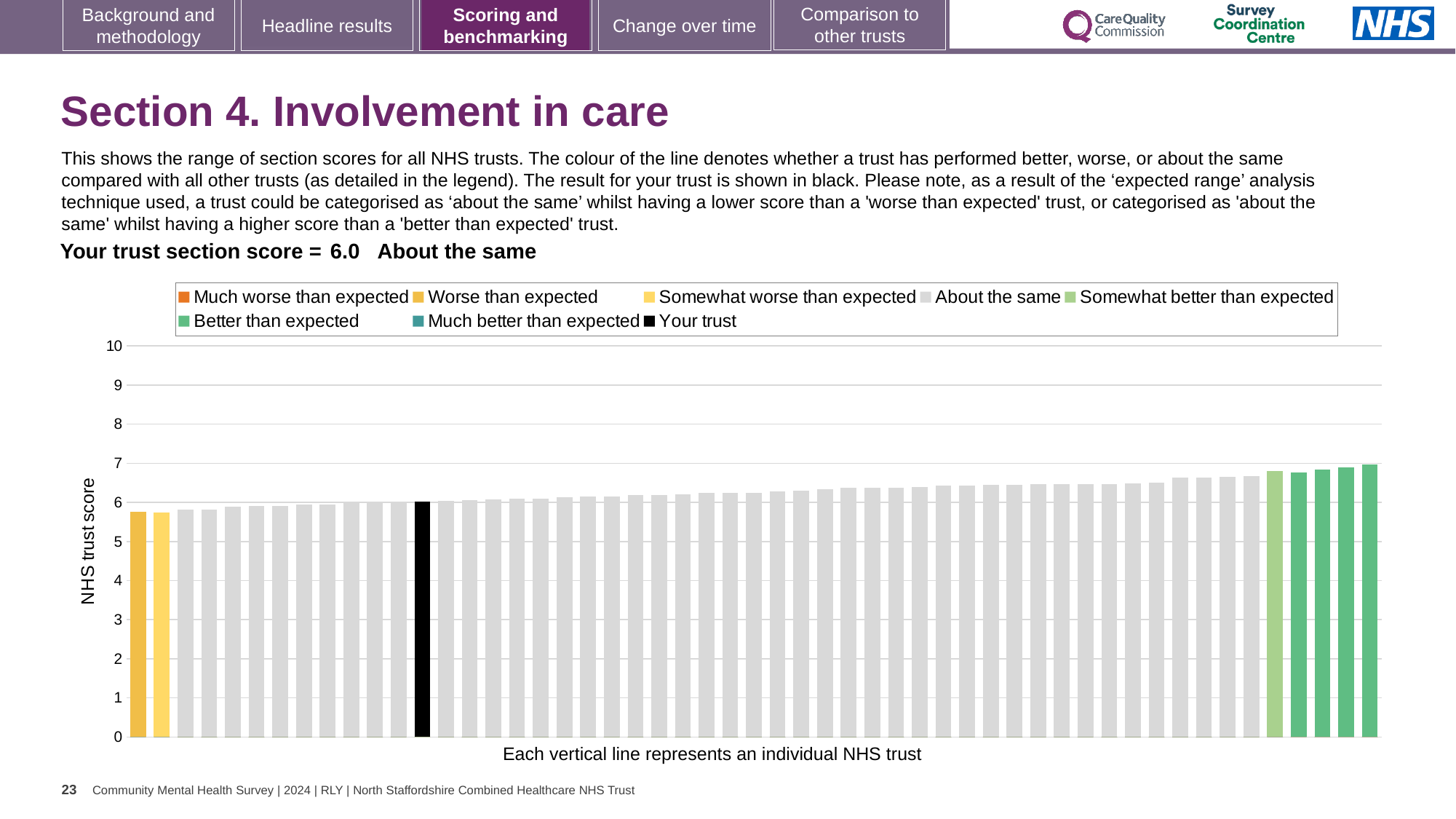
What is the label on the vertical axis of the chart? NHS trust score What is the section score for your trust shown on the slide? 6.0 How many entries does the chart legend list? 8 Is the value of the black 'Your trust' bar greater or less than 5? greater Is the value of the leftmost bar greater or less than 6? less Which category is your trust placed in according to the text above the chart? About the same What kind of chart is shown on the slide? bar chart How many bars are shown in the 'Better than expected' colour? 4 Is the rightmost bar higher or lower than the black 'Your trust' bar? higher Is the value of the rightmost bar greater or less than 6? greater Do the bar values rise or fall from left to right along the x axis? rise What is the highest value shown on the vertical axis? 10